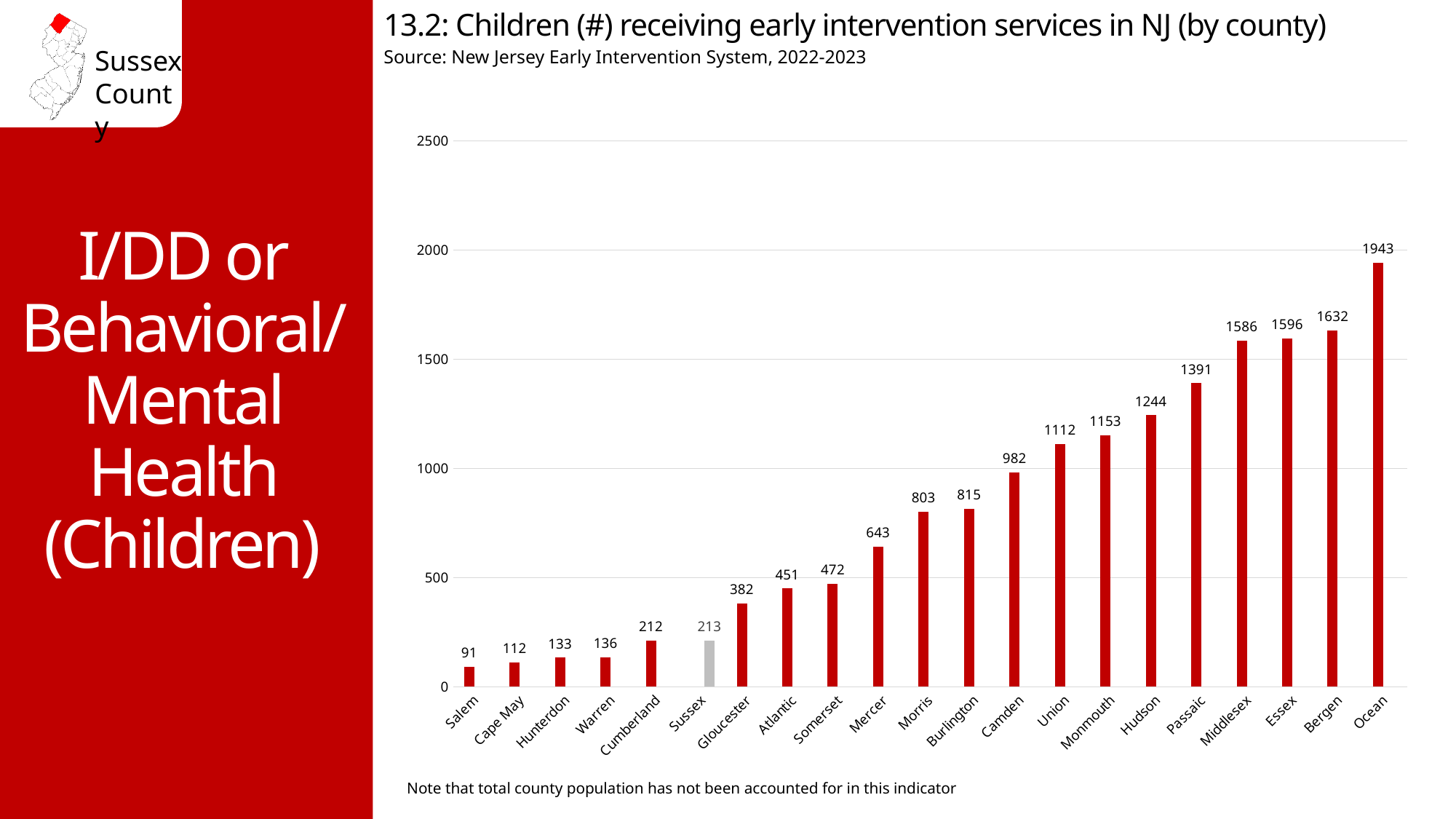
Which county has the lowest number of children receiving early intervention services? Salem What is the value shown for Mercer County? 643 Which county has a larger value, Camden or Morris? Camden What kind of chart is shown on the slide? Bar chart What is the difference between the values for Sussex and Salem? 122 Is the value for Passaic greater or less than 1500? less Which county's bar is shown in gray rather than red? Sussex How many counties are shown on the chart? 21 What is the difference between the values for Bergen and Essex? 36 What is the value shown for Ocean County? 1943 Which county has the highest number of children receiving early intervention services? Ocean How many children are receiving early intervention services in Sussex County? 213